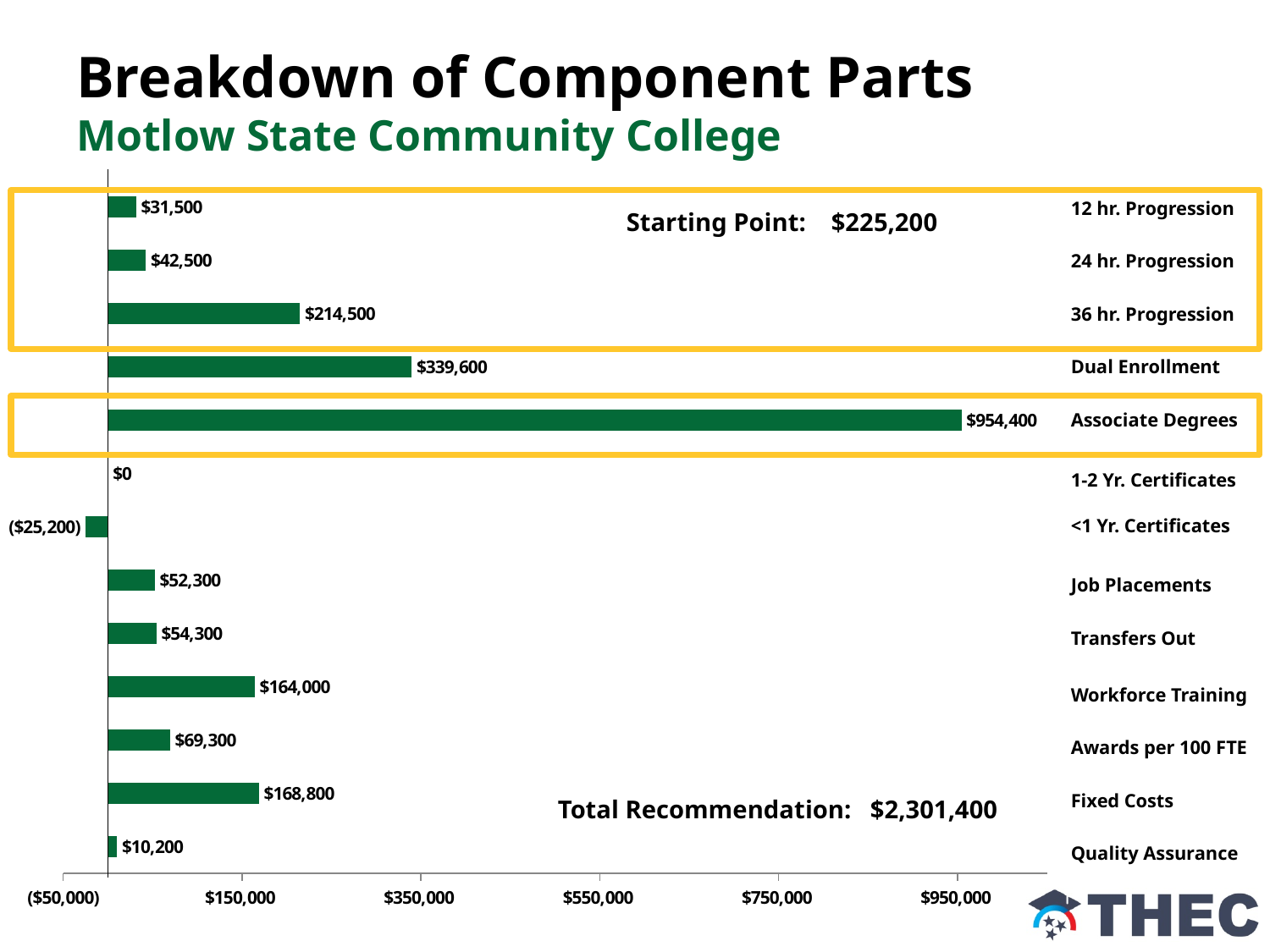
What kind of chart is shown on the slide? Bar chart What is the difference between the values for Dual Enrollment and 36 hr. Progression? $125,100 Is the value for Workforce Training greater or less than $150,000? greater What is the value for <1 Yr. Certificates? ($25,200) What is the value for Dual Enrollment? $339,600 Which is larger, the value for Transfers Out or the value for Job Placements? Transfers Out Which category has the lowest value? <1 Yr. Certificates Which category has the highest value? Associate Degrees What is the value for Quality Assurance? $10,200 How many categories are shown in the chart? 13 What is the value for Associate Degrees? $954,400 What is the difference between the values for Fixed Costs and Workforce Training? $4,800